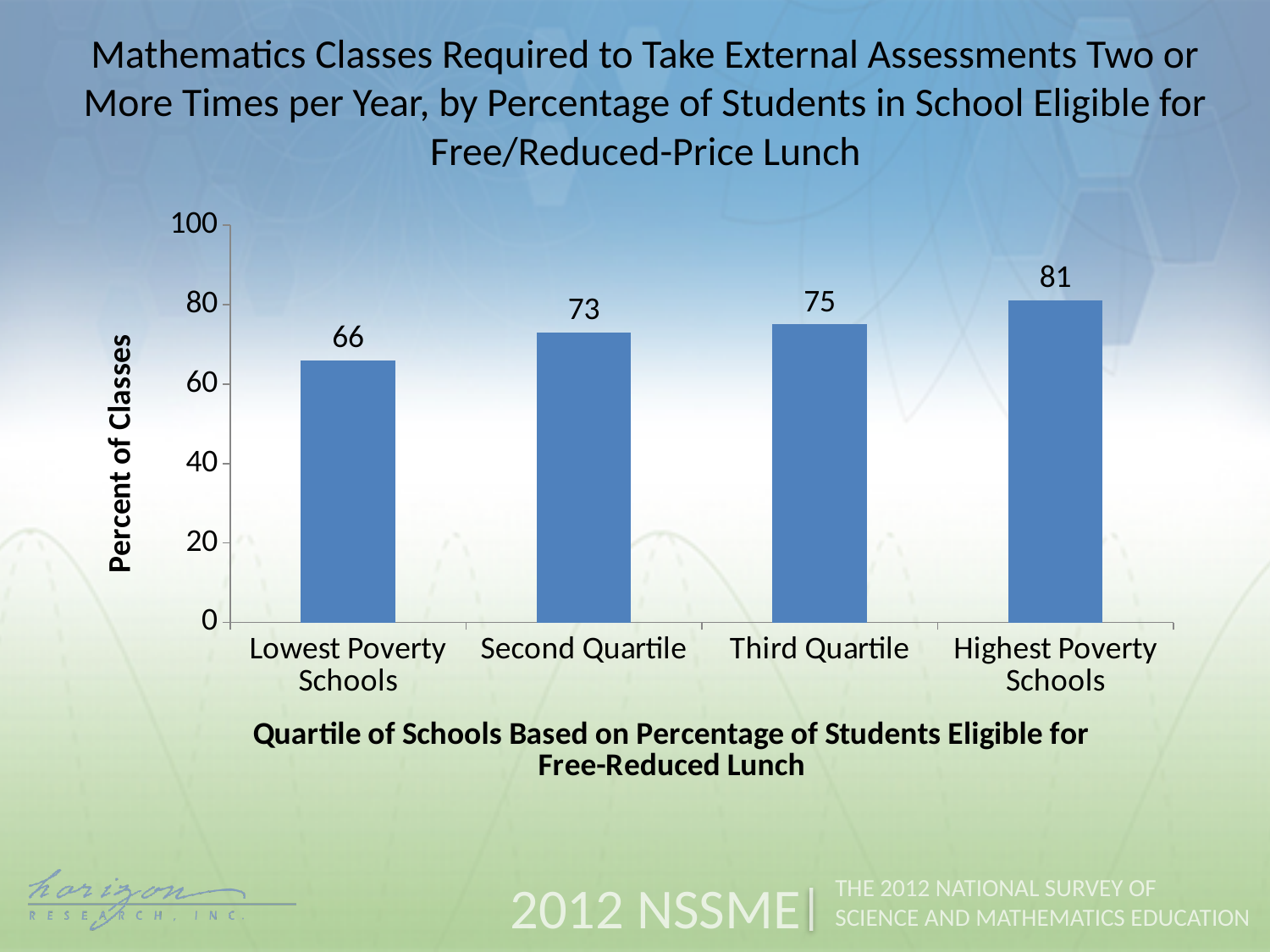
What is the value for Second Quartile? 73 What kind of chart is shown on the slide? bar chart Which category has the lowest value? Lowest Poverty Schools How many categories are shown on the x axis? 4 Which is larger, the value for Second Quartile or the value for Third Quartile? Third Quartile What is the value for Third Quartile? 75 Do the values rise or fall from Lowest Poverty Schools to Highest Poverty Schools? rise What is the value for Highest Poverty Schools? 81 What is the value for Lowest Poverty Schools? 66 Which category has the highest value? Highest Poverty Schools Is the value for Lowest Poverty Schools greater or less than 80? less What is the difference between the values for Highest Poverty Schools and Lowest Poverty Schools? 15